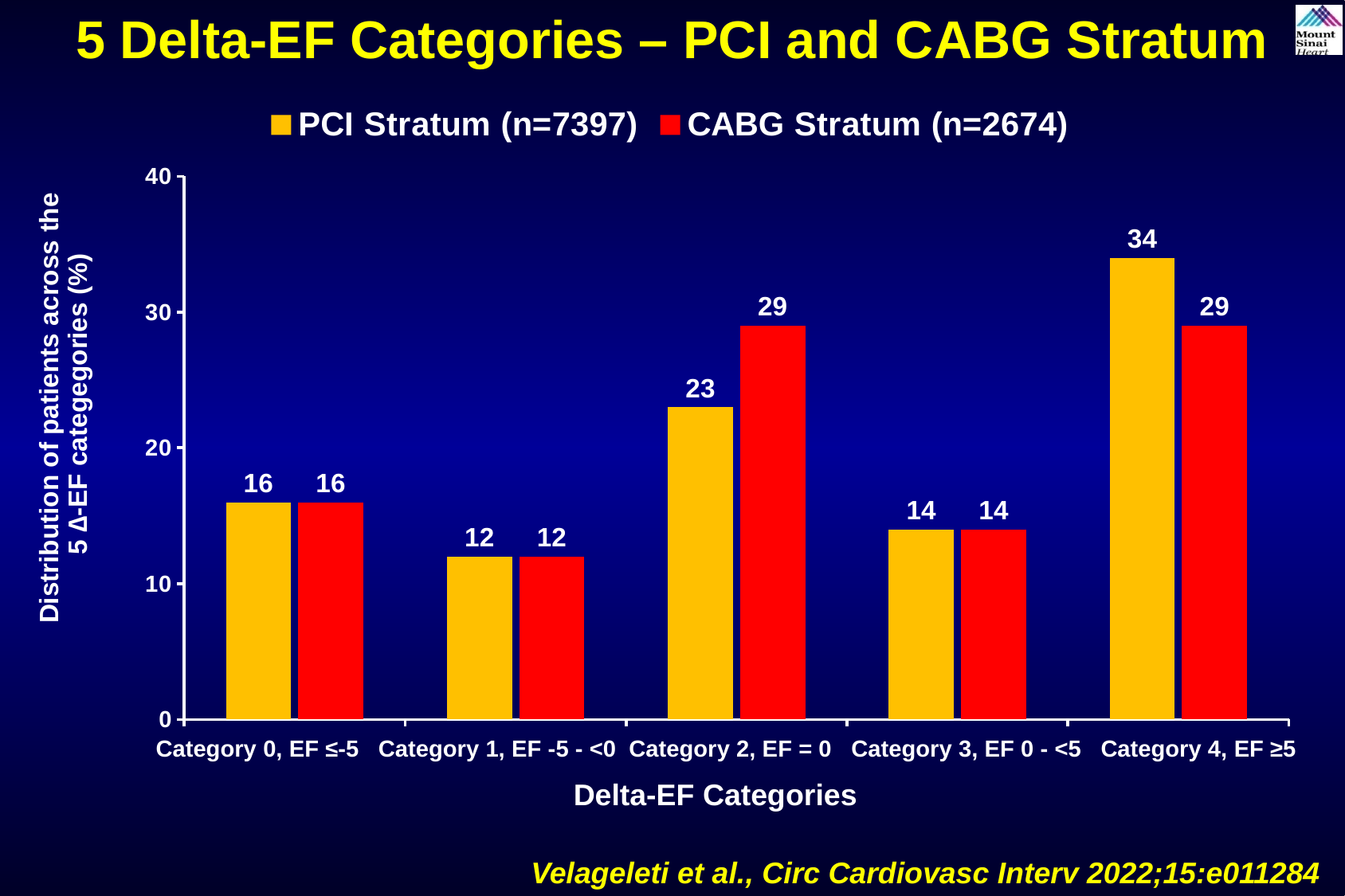
Which category has the lowest value for CABG Stratum? Category 1, EF -5 - <0 What is the value for PCI Stratum in Category 1, EF -5 - <0? 12 Which category has the highest value for PCI Stratum? Category 4, EF ≥5 What is the value for CABG Stratum in Category 4, EF ≥5? 29 Is the value for PCI Stratum in Category 4, EF ≥5 greater or less than 30? greater How many series does the legend list? 2 What is the difference between the PCI Stratum and CABG Stratum values in Category 4, EF ≥5? 5 What kind of chart is shown on the slide? Bar chart Which is larger in Category 2, EF = 0: the PCI Stratum value or the CABG Stratum value? CABG Stratum What is the value for PCI Stratum in Category 2, EF = 0? 23 How many Delta-EF categories are shown on the x axis? 5 What is the sample size of the CABG Stratum shown in the legend? n=2674